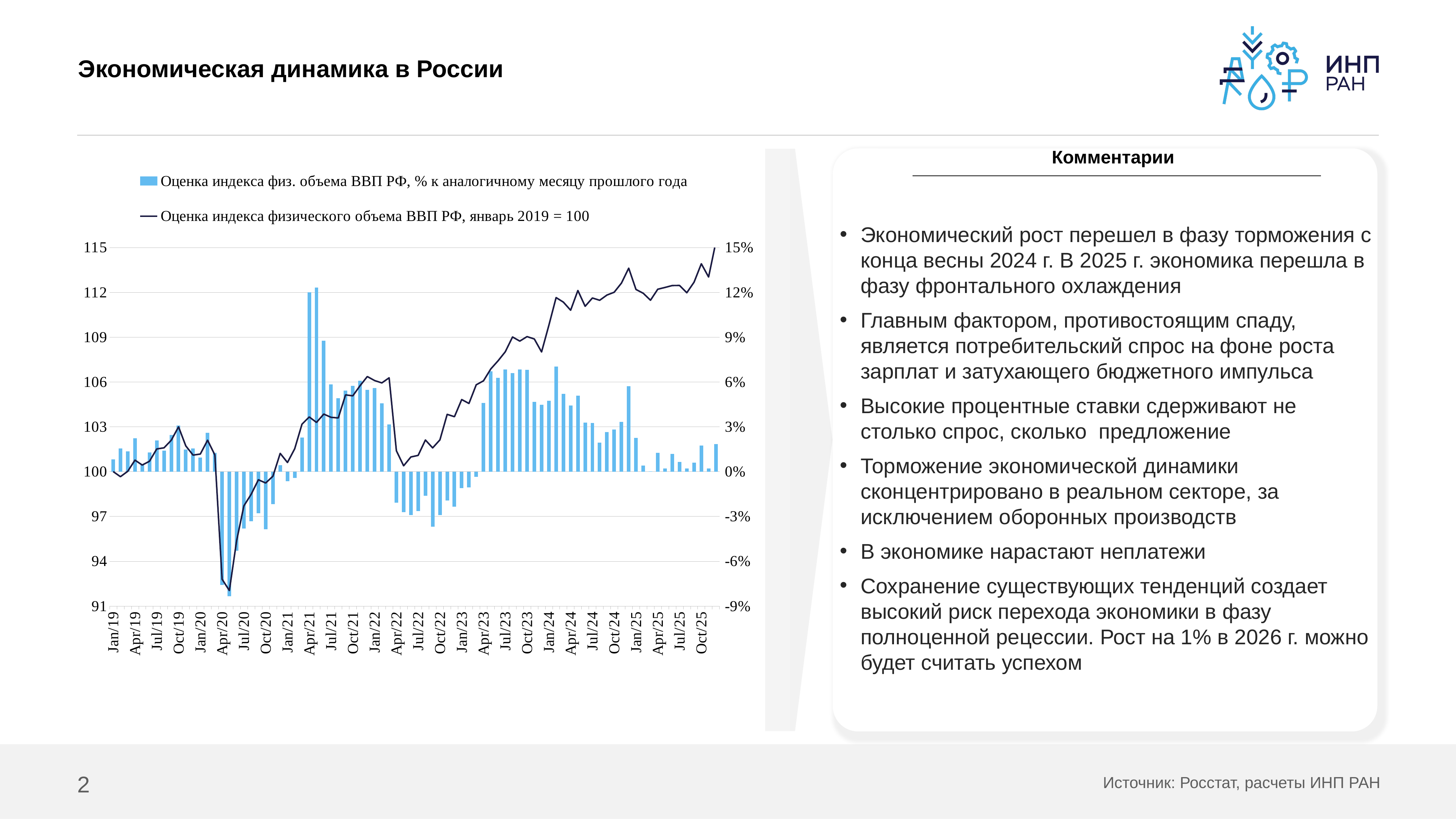
Is the line value for Apr/20 greater or less than 94? less How many series does the chart legend list? 2 Which series is drawn as bars? Оценка индекса физ. объема ВВП РФ, % к аналогичному месяцу прошлого года Is the bar value for Apr/20 greater or less than -6%? less Is the bar value for Jul/22 greater or less than 0%? less In which month do the bars reach their lowest value? May/20 Do the bar values generally rise or fall from Jan/24 to Oct/25? fall Which is larger, the line value in Oct/25 or in Jan/19? Oct/25 What kind of chart is shown on the slide? A combined bar and line chart What is the value of the line series (index, January 2019 = 100) in Jan/19? 100